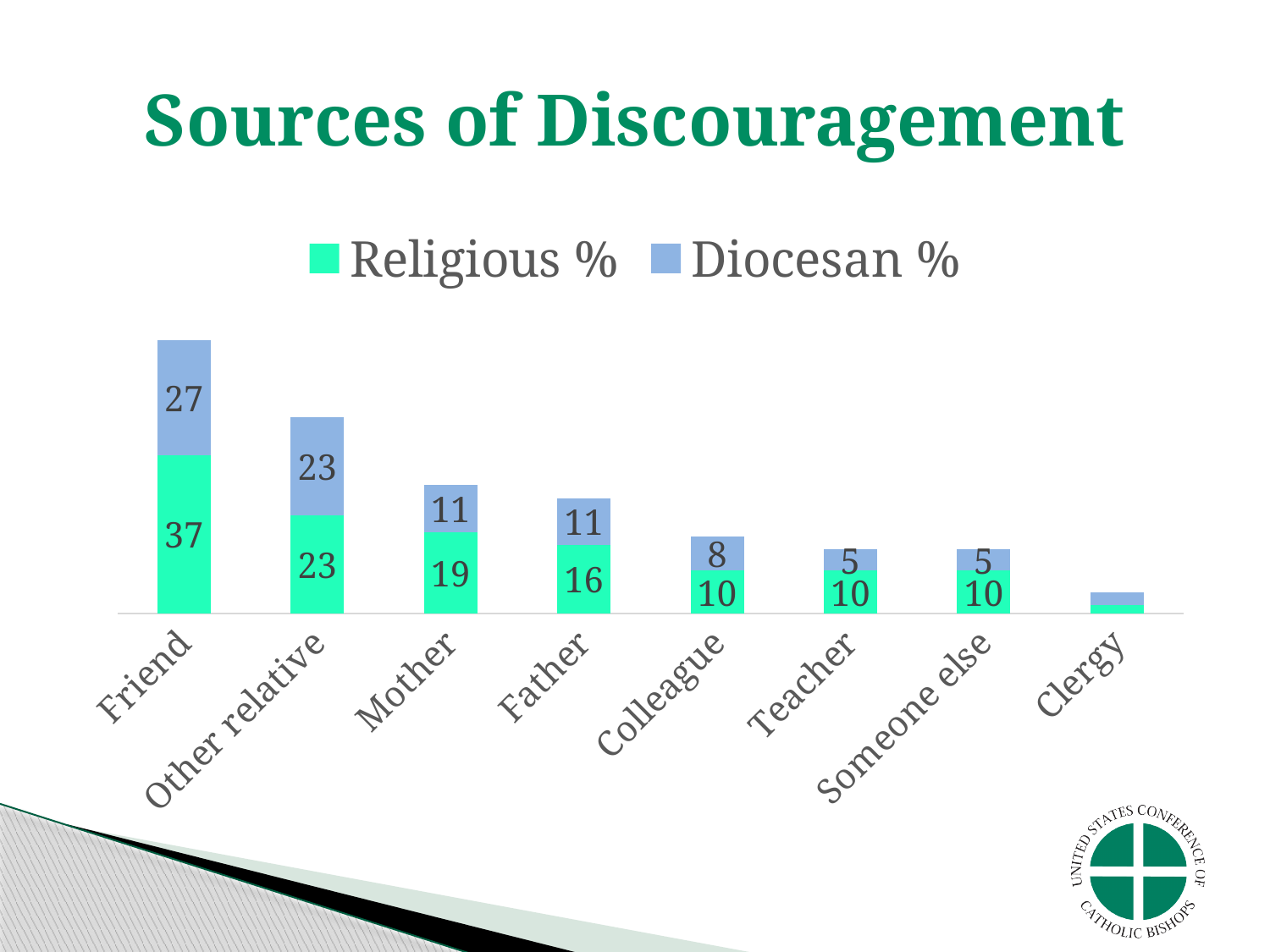
Which category has the highest Religious % value? Friend What is the Diocesan % value for Colleague? 8 What is the difference between the Religious % values for Friend and Other relative? 14 Which is larger, the Diocesan % value for Friend or for Other relative? Friend How many categories are shown on the x axis? 8 What is the Religious % value for Father? 16 How many series does the legend list? 2 What is the total of the stacked bar for Friend? 64 Which category has the lowest Diocesan % value? Clergy What kind of chart is shown on the slide? Stacked bar chart What is the Diocesan % value for Mother? 11 What is the Religious % value for Friend? 37